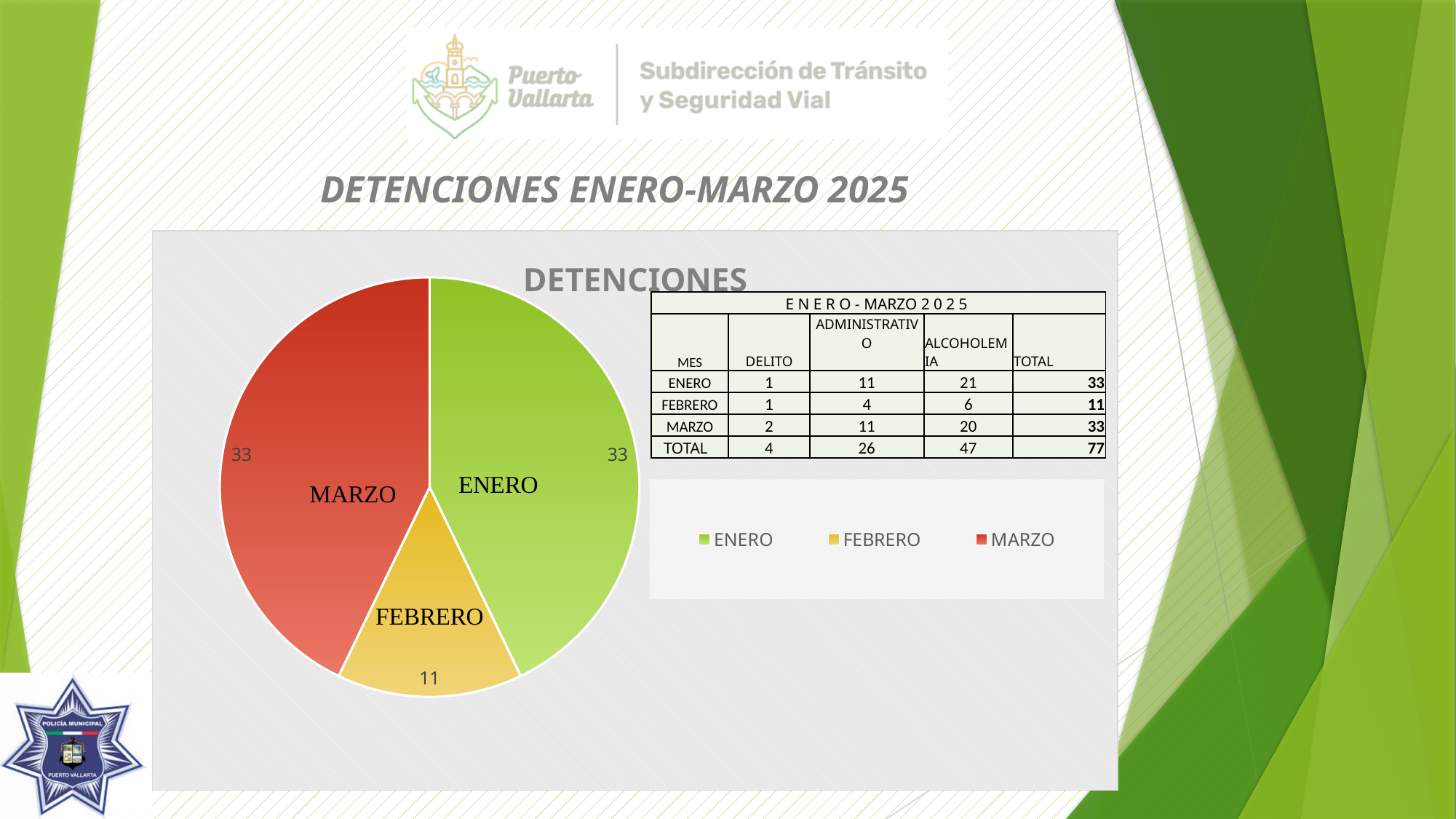
What is the value of the FEBRERO slice in the DETENCIONES pie chart? 11 What colour is the MARZO slice in the DETENCIONES pie chart? Red In the DETENCIONES pie chart, which is larger, the MARZO slice or the FEBRERO slice? MARZO How many slices does the DETENCIONES pie chart have? 3 What is the value of the ENERO slice in the DETENCIONES pie chart? 33 What is the value of the MARZO slice in the DETENCIONES pie chart? 33 What is the difference between the ENERO and FEBRERO values in the DETENCIONES pie chart? 22 What is the title of the pie chart on the slide? DETENCIONES What kind of chart is used to show the DETENCIONES data? Pie chart Which month has the smallest slice in the DETENCIONES pie chart? FEBRERO How many entries does the legend of the DETENCIONES chart list? 3 What is the sum of all three slices in the DETENCIONES pie chart? 77